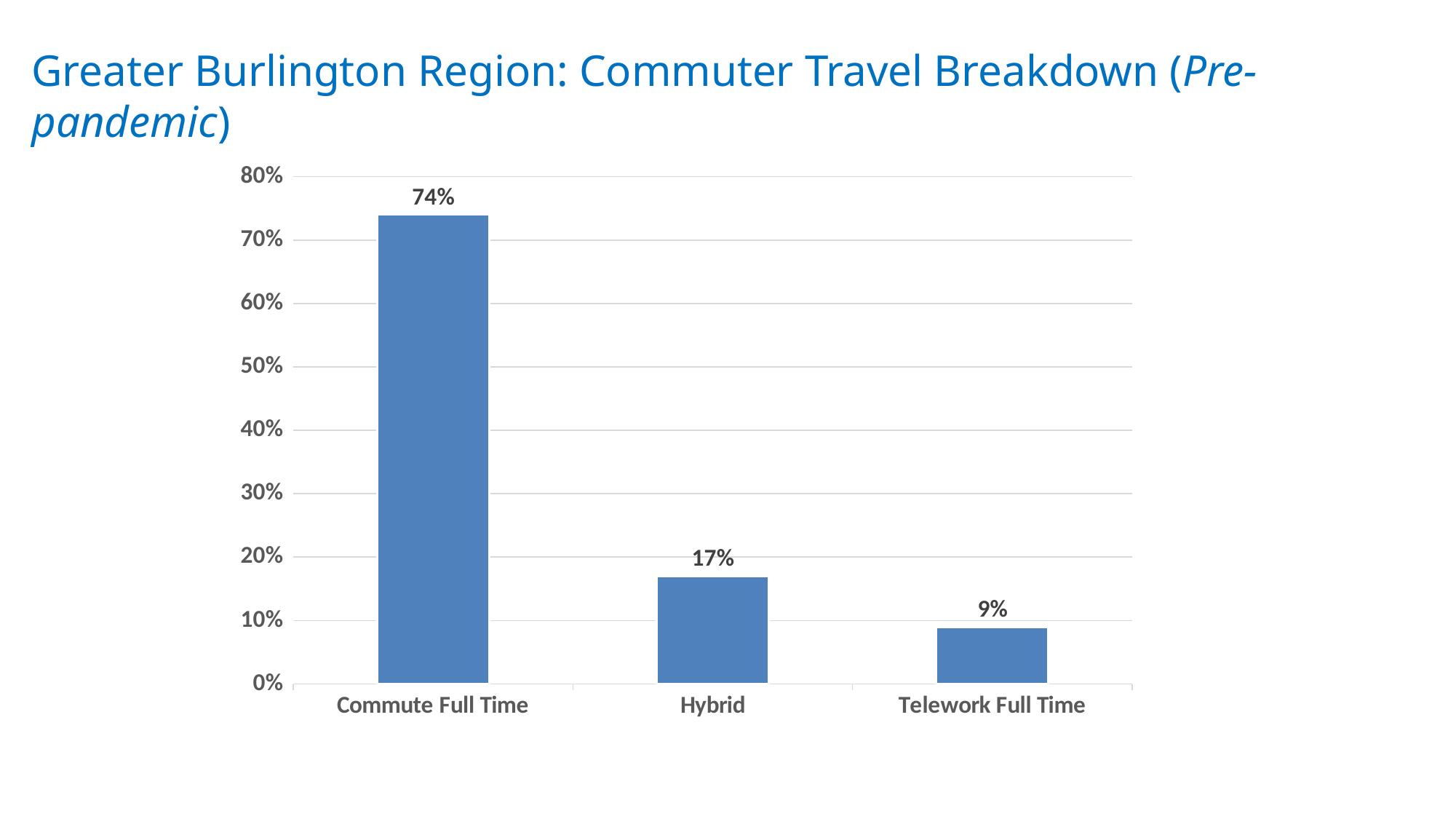
Is the value for Commute Full Time greater or less than 70%? greater Which category has the lowest value? Telework Full Time How many categories are shown on the x axis? 3 What is the value for Hybrid? 17% Which category has the highest value? Commute Full Time What is the title of the slide? Greater Burlington Region: Commuter Travel Breakdown (Pre-pandemic) What is the difference between the values for Commute Full Time and Hybrid? 57% What kind of chart is shown on the slide? bar chart What is the difference between the values for Hybrid and Telework Full Time? 8% Which is larger, the value for Hybrid or the value for Telework Full Time? Hybrid What is the value for Telework Full Time? 9% What is the value for Commute Full Time? 74%